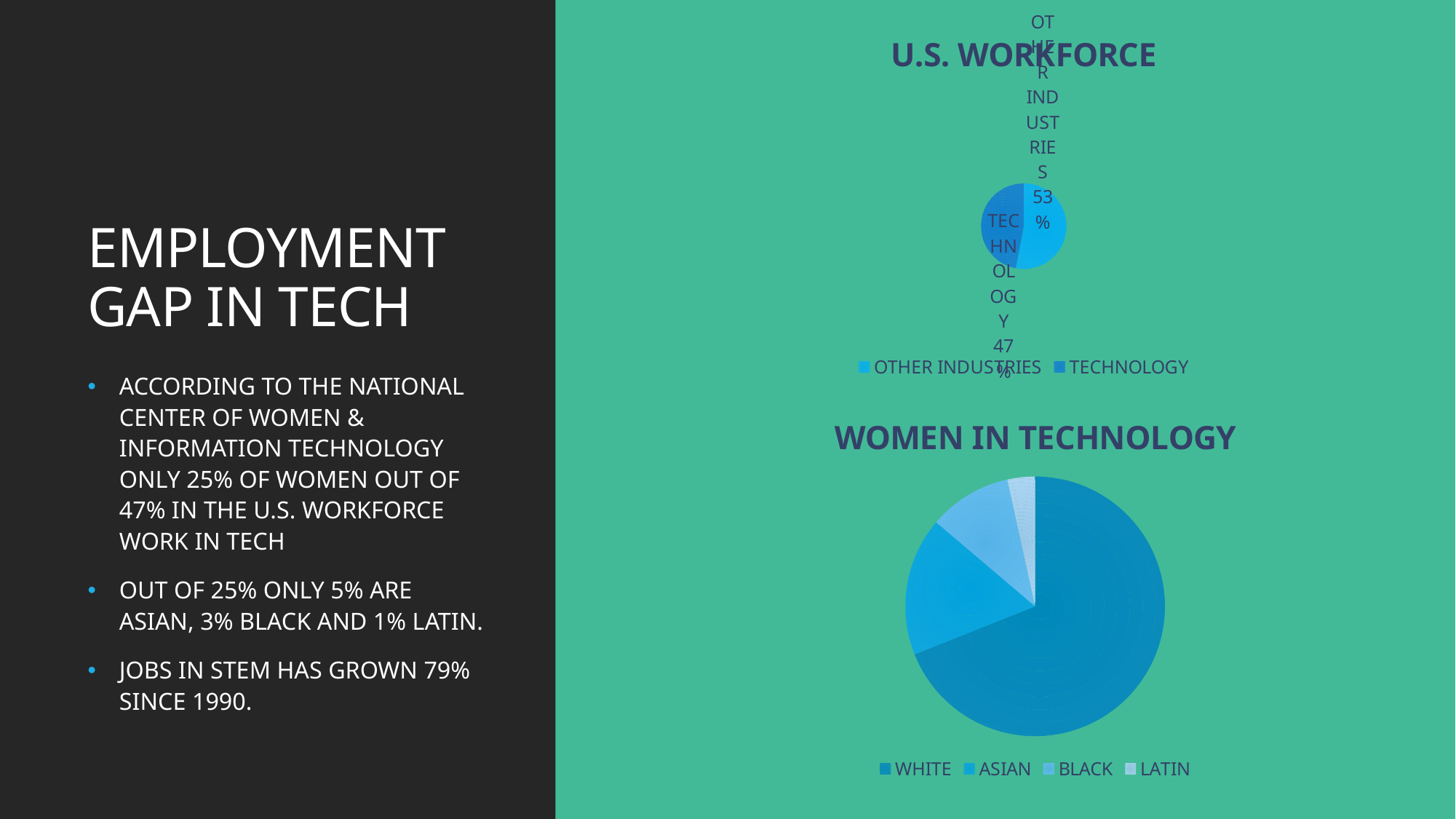
In the WOMEN IN TECHNOLOGY pie chart, which category has the smallest slice? LATIN In the U.S. WORKFORCE pie chart, which slice is larger, OTHER INDUSTRIES or TECHNOLOGY? OTHER INDUSTRIES What are the legend entries of the WOMEN IN TECHNOLOGY chart, in order? WHITE, ASIAN, BLACK, LATIN In the U.S. WORKFORCE pie chart, what percentage is shown for OTHER INDUSTRIES? 53% How many categories does the legend of the WOMEN IN TECHNOLOGY chart list? 4 What kind of chart is the U.S. WORKFORCE chart? Pie chart In the WOMEN IN TECHNOLOGY pie chart, which category has the largest slice? WHITE What kind of chart is the WOMEN IN TECHNOLOGY chart? Pie chart In the U.S. WORKFORCE pie chart, what percentage is shown for TECHNOLOGY? 47% In the WOMEN IN TECHNOLOGY pie chart, which slice is larger, ASIAN or BLACK? ASIAN How many categories does the legend of the U.S. WORKFORCE chart list? 2 In the U.S. WORKFORCE pie chart, what is the difference between the OTHER INDUSTRIES share and the TECHNOLOGY share? 6%